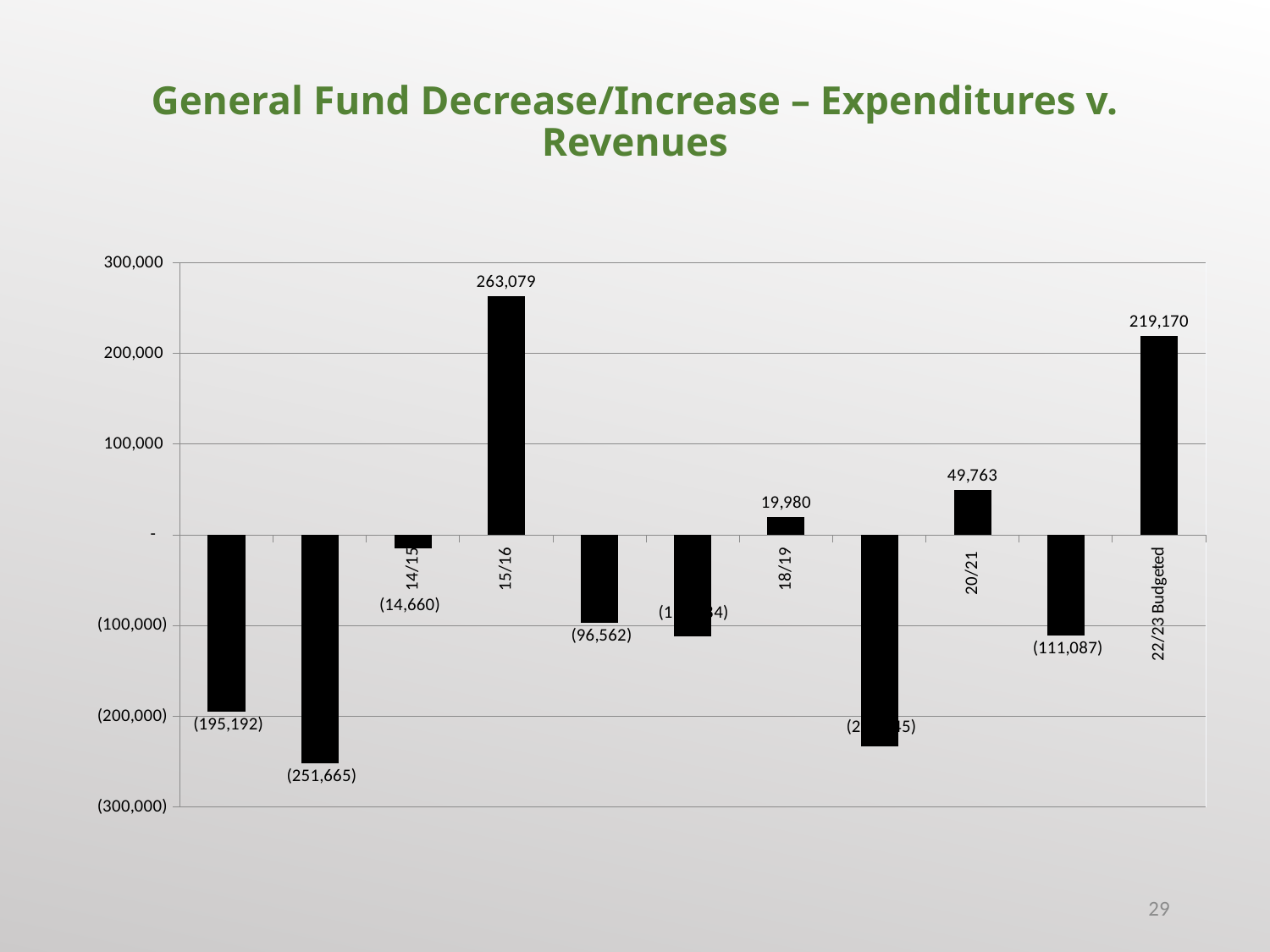
Which year has the highest value in the chart? 15/16 What is the difference between the values for 15/16 and 22/23 Budgeted? 43,909 What is the value for 18/19? 19,980 What is the lowest value shown in the chart? (251,665) What type of chart is shown on the slide? bar chart What is the value for 14/15? (14,660) Which is larger, the value for 20/21 or the value for 18/19? 20/21 What is the value for 22/23 Budgeted? 219,170 What is the value for 15/16? 263,079 Is the value for 20/21 greater or less than 100,000? less How many bars are plotted in the chart? 11 What is the value for 20/21? 49,763